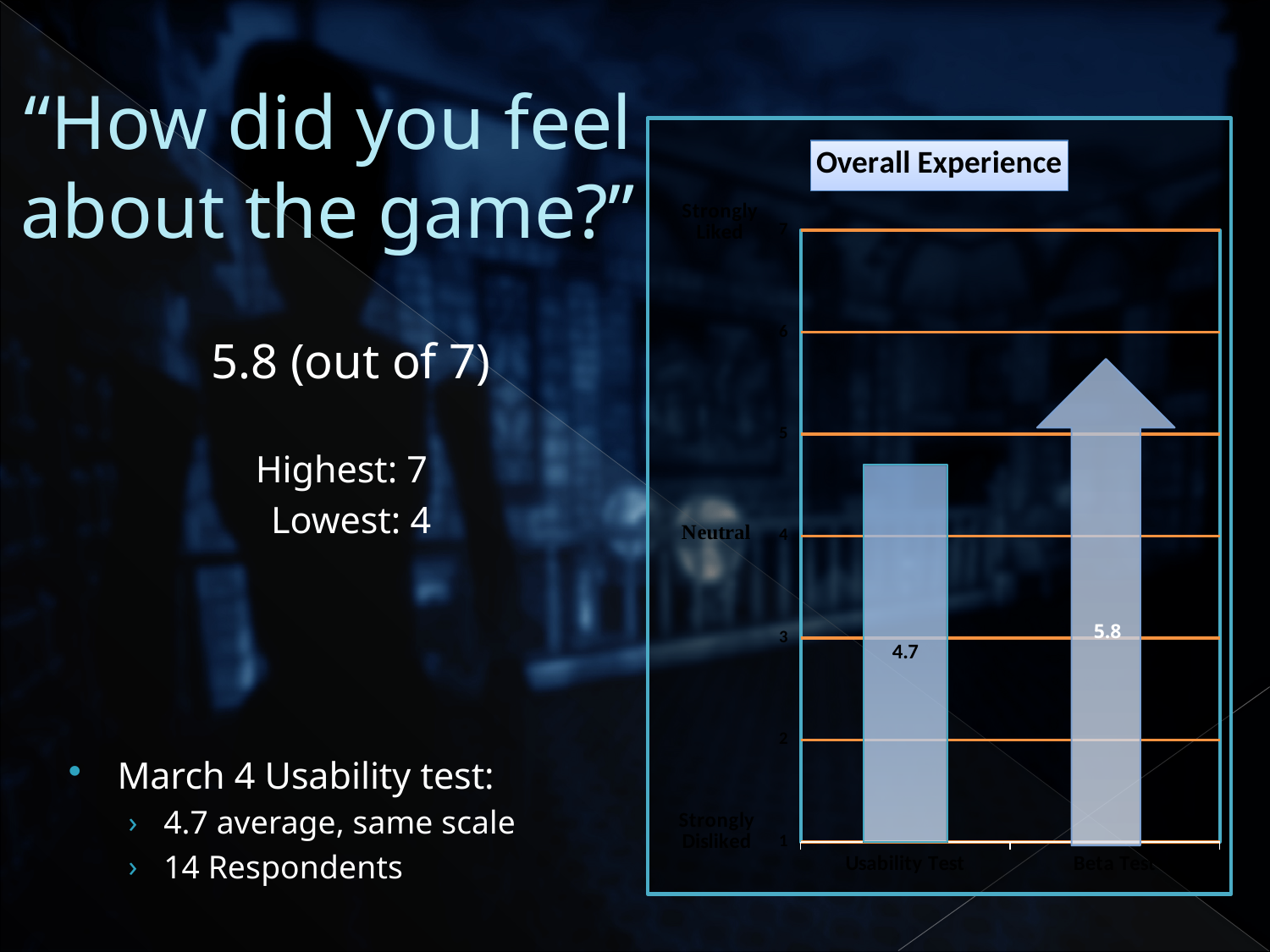
What label is shown at the value 4 on the y axis of the Overall Experience chart? Neutral What is the value for Usability Test in the Overall Experience chart? 4.7 What is the title of the chart on the slide? Overall Experience Is the value for Beta Test in the Overall Experience chart greater or less than 5? greater What is the difference between the Beta Test and Usability Test values in the Overall Experience chart? 1.1 Which category has the highest value in the Overall Experience chart? Beta Test What is the value for Beta Test in the Overall Experience chart? 5.8 Which is larger in the Overall Experience chart, the Usability Test value or the Beta Test value? Beta Test How many categories are shown in the Overall Experience chart? 2 Is the value for Usability Test in the Overall Experience chart greater or less than 5? less What kind of chart is the Overall Experience chart? bar chart Which category has the lowest value in the Overall Experience chart? Usability Test